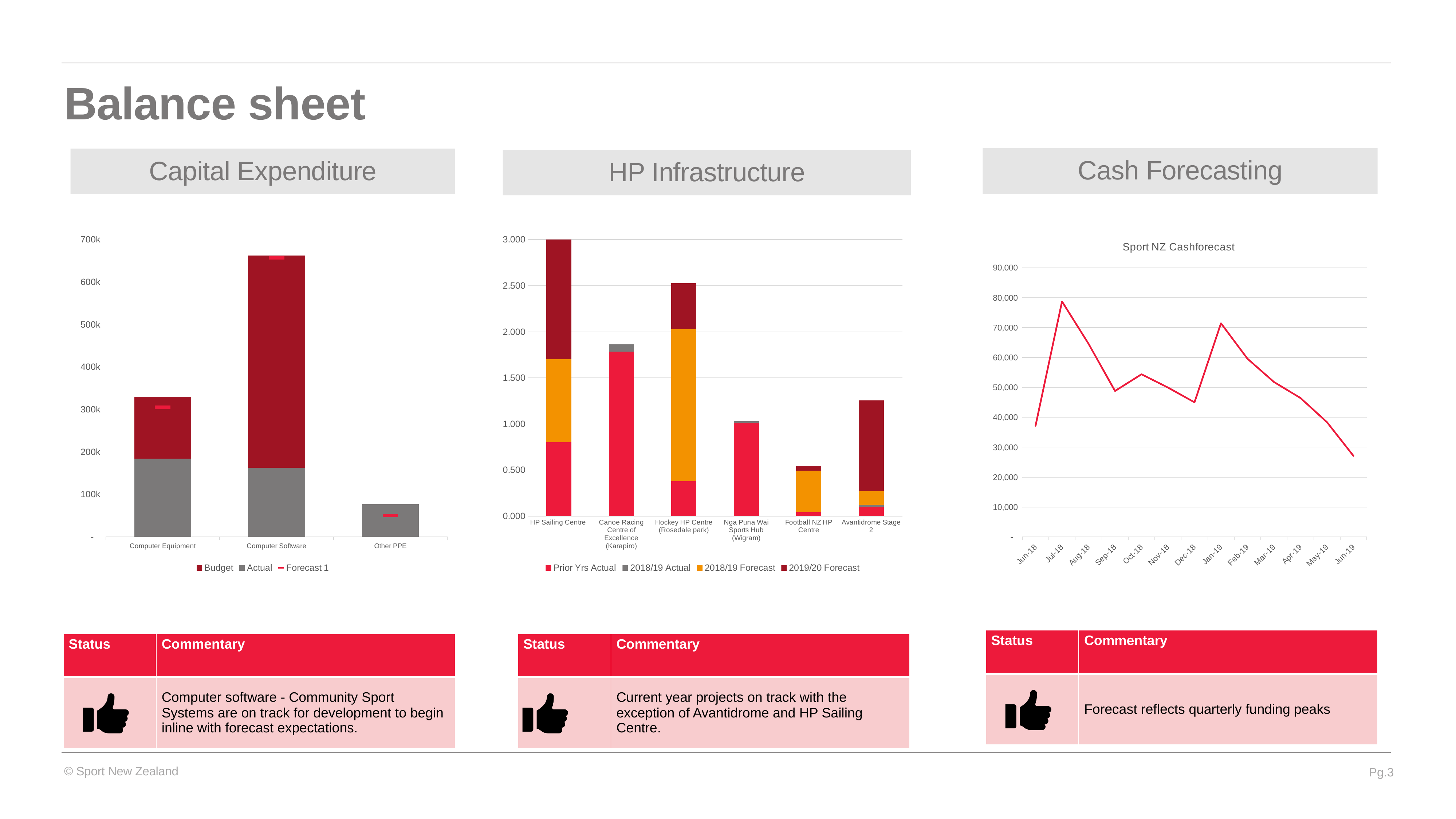
On the Cash Forecasting chart, is the value for Jun-19 greater or less than 30,000? less On the HP Infrastructure chart, which has the larger total stacked bar: Hockey HP Centre (Rosedale park) or Canoe Racing Centre of Excellence (Karapiro)? Hockey HP Centre (Rosedale park) On the Capital Expenditure chart, which category has the shortest stacked bar? Other PPE On the Capital Expenditure chart, is the value for Other PPE greater or less than 100k? less On the Cash Forecasting chart, which month has the highest value? Jul-18 On the Capital Expenditure chart, which category has the tallest stacked bar? Computer Software On the Capital Expenditure chart, is the total stacked value for Computer Software greater or less than 600k? greater On the Capital Expenditure chart, how many series does the legend list? 3 On the HP Infrastructure chart, what kind of chart is used? Stacked bar chart On the HP Infrastructure chart, which project has the lowest total stacked bar? Football NZ HP Centre On the HP Infrastructure chart, how many project categories are shown on the x axis? 6